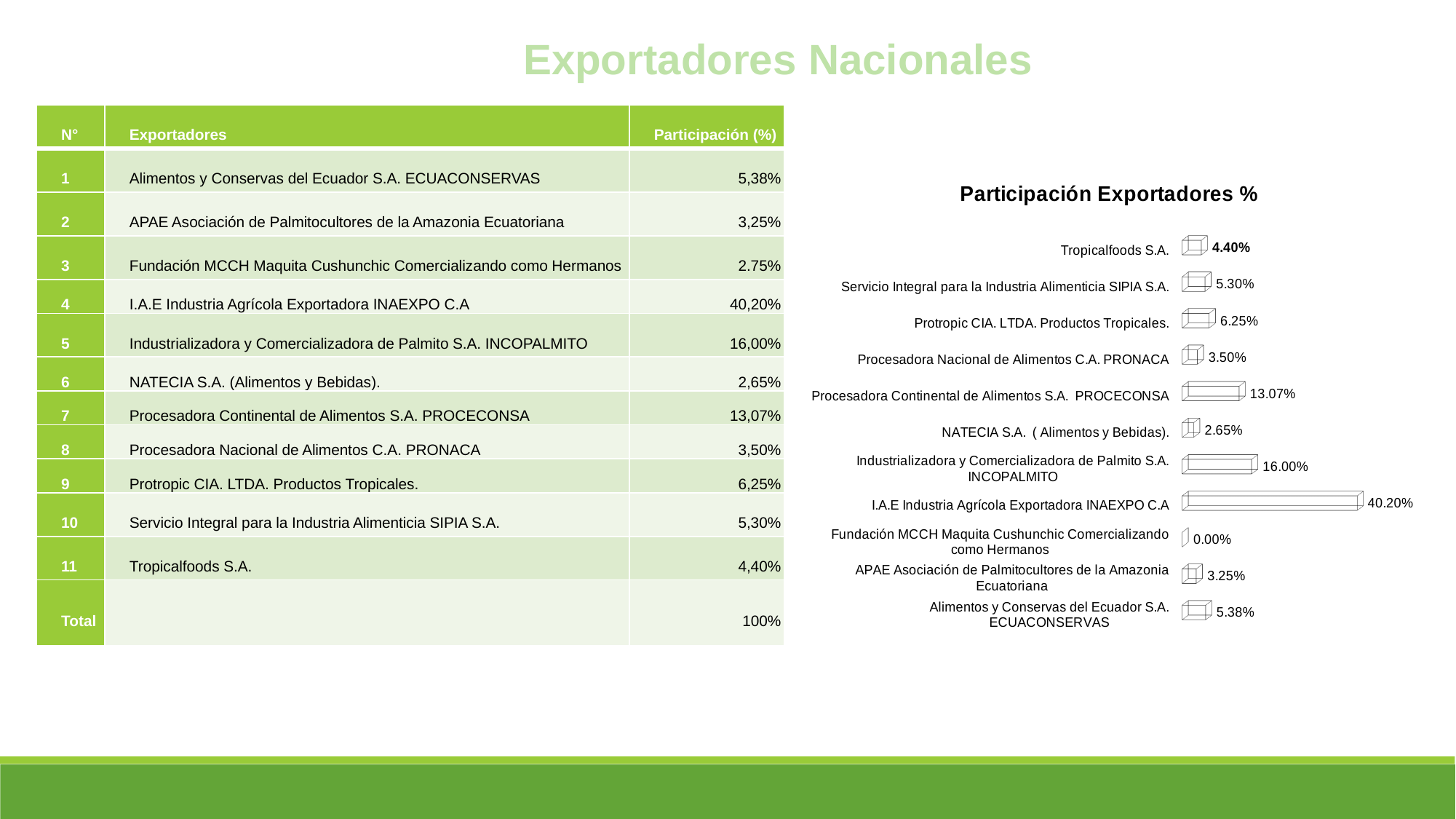
What is the title of the chart on the slide? Participación Exportadores % Which exporter has the highest value in the chart? I.A.E Industria Agrícola Exportadora INAEXPO C.A In the chart, which is larger: the value for Protropic CIA. LTDA. Productos Tropicales or the value for Servicio Integral para la Industria Alimenticia SIPIA S.A.? Protropic CIA. LTDA. Productos Tropicales In the chart, what is the difference between the values for INAEXPO C.A and INCOPALMITO? 24.20% In the chart, what is the value for I.A.E Industria Agrícola Exportadora INAEXPO C.A? 40.20% In the chart, what is the value for Procesadora Continental de Alimentos S.A. PROCECONSA? 13.07% In the chart, what is the difference between the values for INCOPALMITO and PROCECONSA? 2.93% Which exporter has the lowest value in the chart? Fundación MCCH Maquita Cushunchic Comercializando como Hermanos What kind of chart is shown on the slide? bar chart How many exporters are plotted in the chart? 11 In the chart, what is the value for Fundación MCCH Maquita Cushunchic Comercializando como Hermanos? 0.00% In the chart, what is the value for Tropicalfoods S.A.? 4.40%